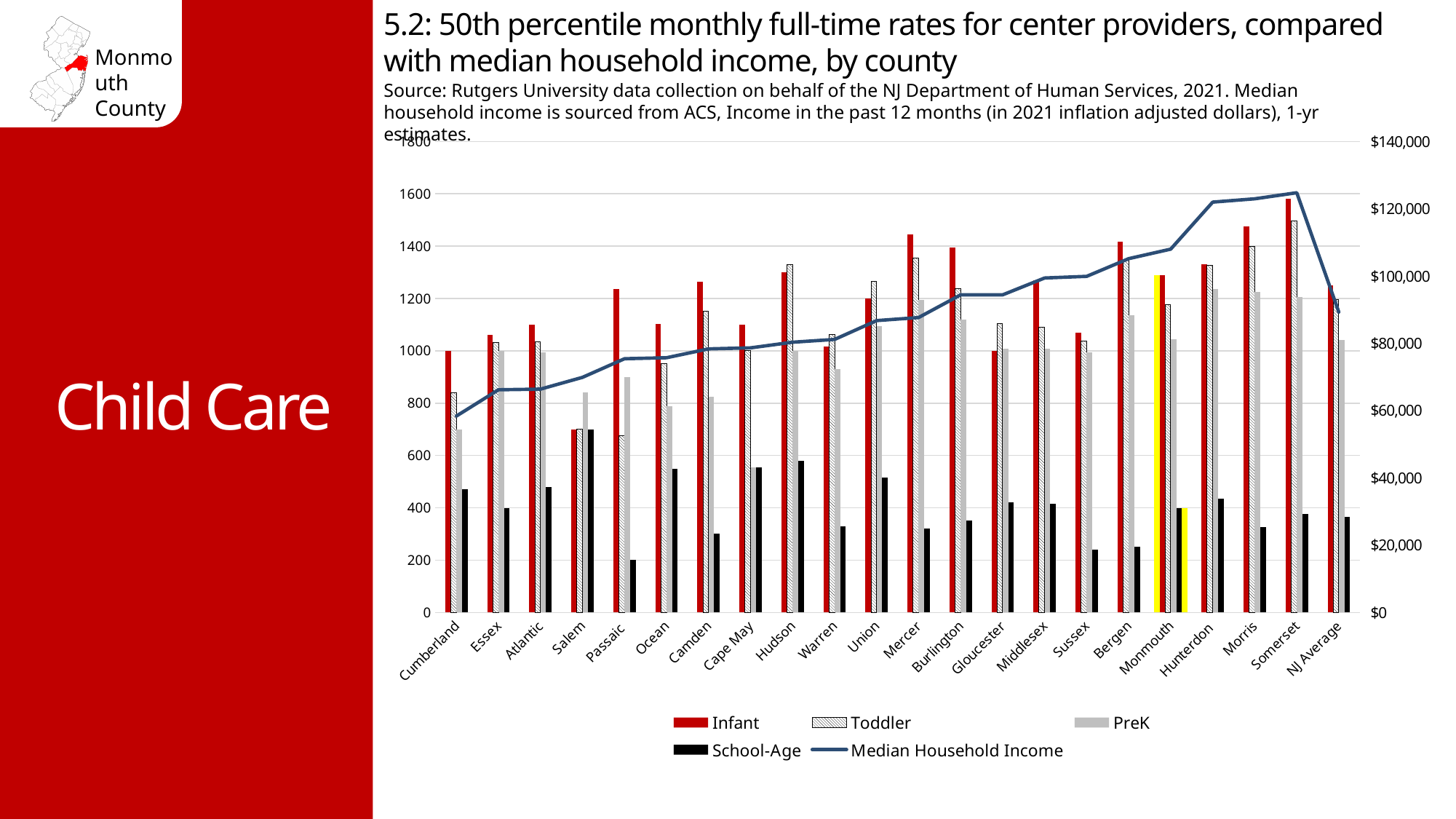
Is the Median Household Income for Cumberland greater or less than $80,000? less Which county has the lowest Median Household Income? Cumberland What kind of chart is shown on the slide? Bar chart with a line series Does the Median Household Income line generally rise or fall from Cumberland to Somerset? rise Which county has the lowest Infant rate? Salem How many counties/categories are shown along the x axis? 22 How many series does the legend list? 5 Which county has the highest School-Age rate? Salem Is the Infant rate for Somerset greater or less than 1400? greater Which county has the highest Infant rate? Somerset Which county has the lowest School-Age rate? Passaic Which is larger, the Toddler rate for Hudson or the Toddler rate for Cumberland? Hudson